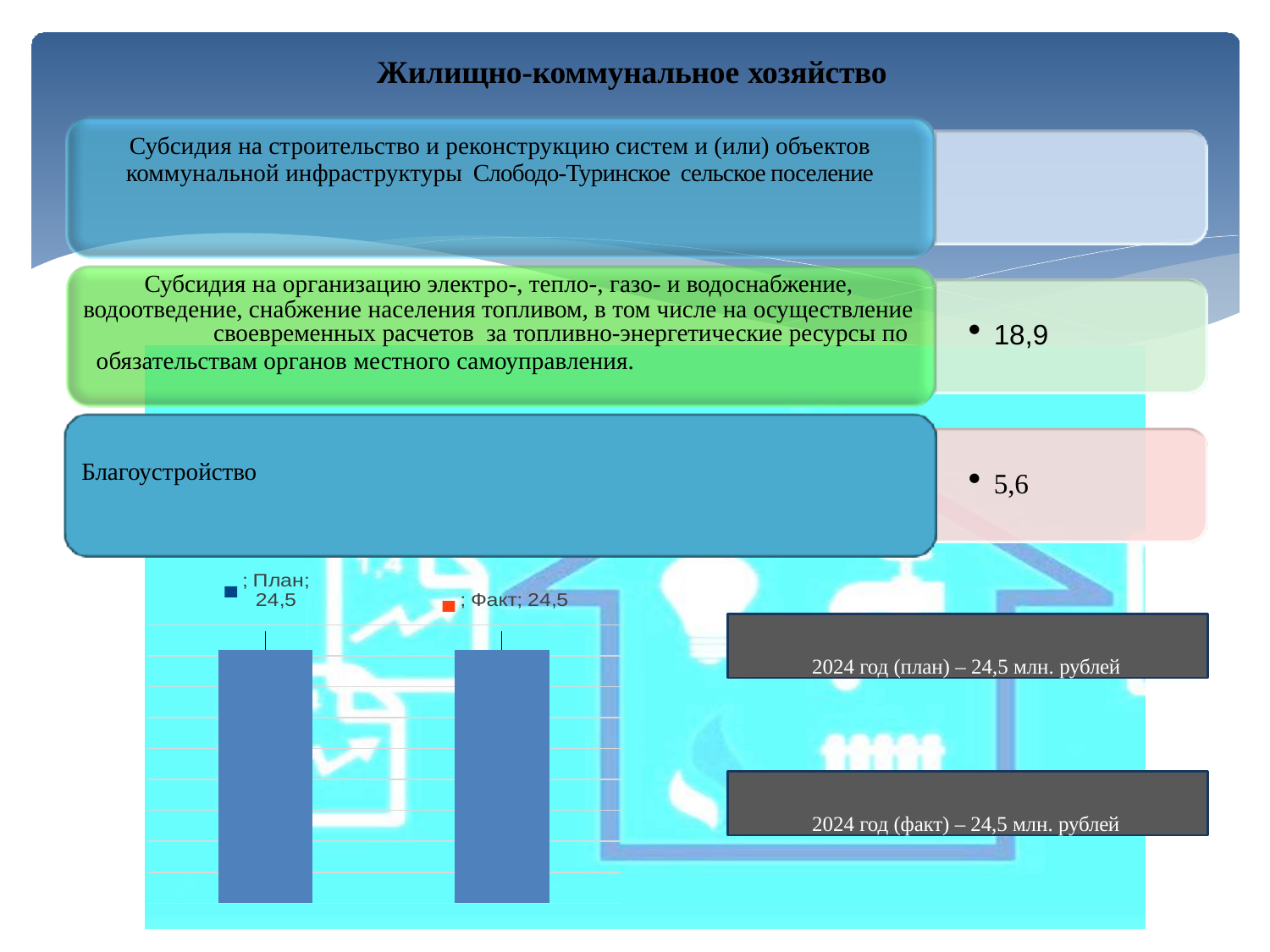
What colour are the bars in the chart? blue What is the difference between the План and Факт values in the chart? 0 What kind of chart is shown at the bottom left of the slide? bar chart What is the value shown for План in the chart? 24,5 What are the two categories labelled in the chart? План and Факт How many bars are plotted in the chart? 2 What is the value shown for Факт in the chart? 24,5 Are the План and Факт values in the chart equal or different? equal